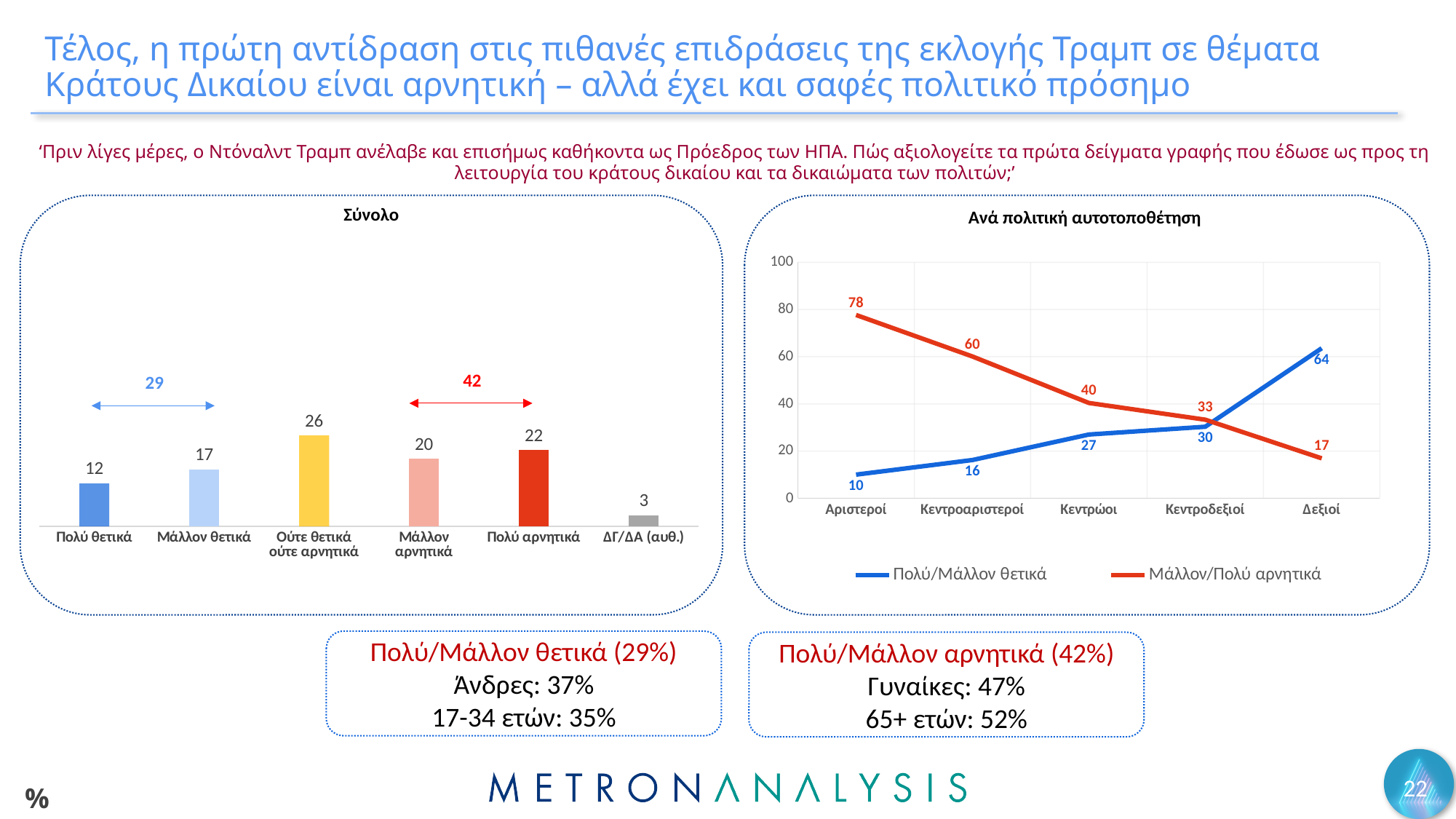
In the 'Σύνολο' chart, what is the value for 'Ούτε θετικά ούτε αρνητικά'? 26 In the 'Σύνολο' chart, how many categories are shown on the x axis? 6 In the 'Ανά πολιτική αυτοτοποθέτηση' chart, what is the value of 'Μάλλον/Πολύ αρνητικά' for 'Αριστεροί'? 78 In the 'Σύνολο' chart, which category has the lowest value? ΔΓ/ΔΑ (αυθ.) In the 'Σύνολο' chart, which category has the highest value? Ούτε θετικά ούτε αρνητικά In the 'Ανά πολιτική αυτοτοποθέτηση' chart, what is the value of 'Πολύ/Μάλλον θετικά' for 'Δεξιοί'? 64 What kind of chart is the 'Σύνολο' chart? Bar chart In the 'Ανά πολιτική αυτοτοποθέτηση' chart, does the 'Πολύ/Μάλλον θετικά' series rise or fall from 'Αριστεροί' to 'Δεξιοί'? Rise In the 'Σύνολο' chart, what is the difference between 'Πολύ αρνητικά' and 'Πολύ θετικά'? 10 In the 'Ανά πολιτική αυτοτοποθέτηση' chart, how many series does the legend list? 2 In the 'Ανά πολιτική αυτοτοποθέτηση' chart, what is the difference between 'Μάλλον/Πολύ αρνητικά' and 'Πολύ/Μάλλον θετικά' for 'Κεντροαριστεροί'? 44 In the 'Ανά πολιτική αυτοτοποθέτηση' chart, which is larger for 'Κεντρώοι': 'Πολύ/Μάλλον θετικά' or 'Μάλλον/Πολύ αρνητικά'? Μάλλον/Πολύ αρνητικά